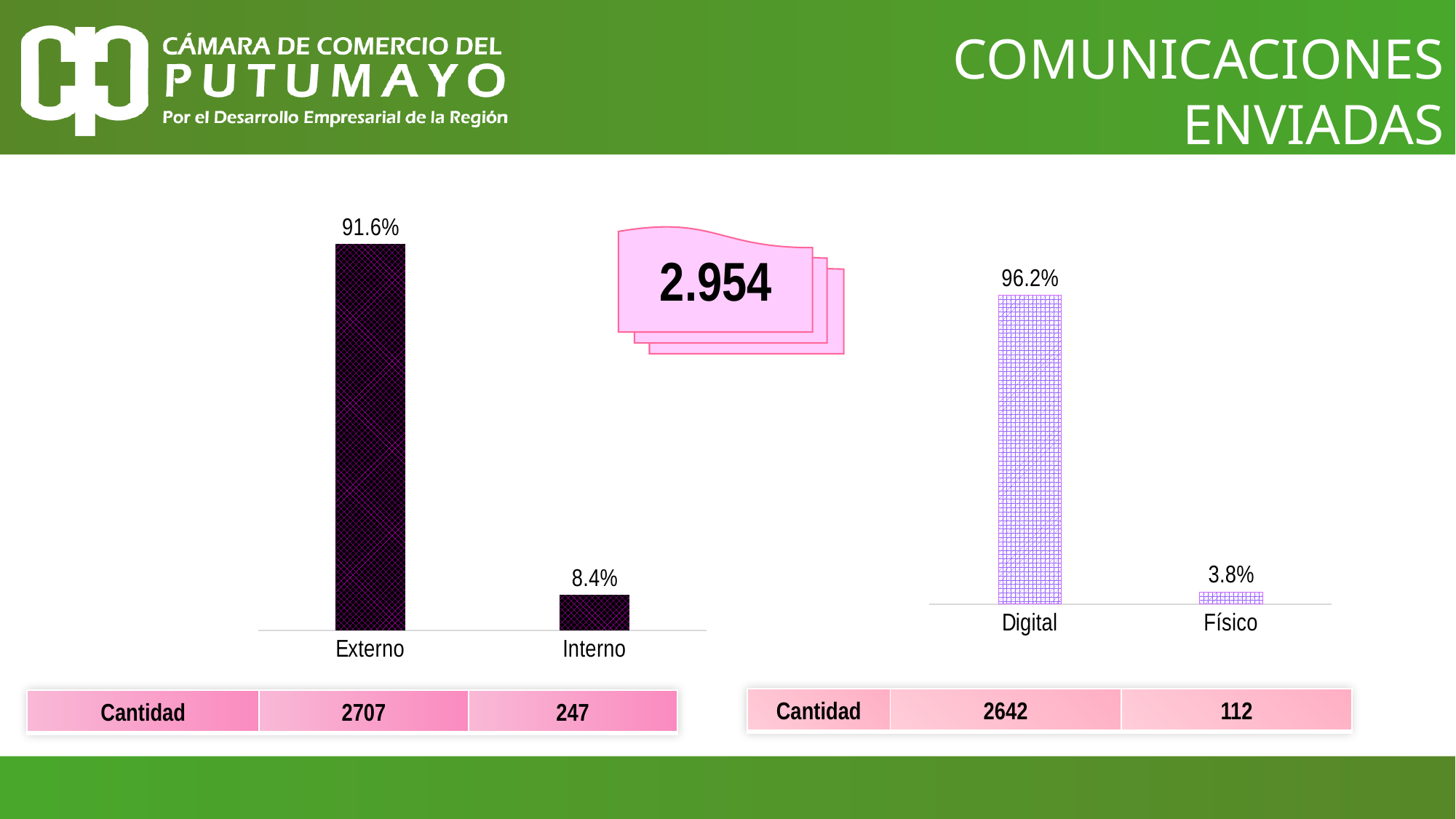
In the left chart, what percentage is shown for Interno? 8.4% In the left chart, which category has the highest value? Externo In the right chart, which category has the lowest value? Físico In the right chart, what is the difference in percentage points between Digital and Físico? 92.4 In the right chart, what percentage is shown for Digital? 96.2% What kind of chart is the right chart? bar chart In the right chart, which is larger, Digital or Físico? Digital In the left chart, what percentage is shown for Externo? 91.6% In the left chart, what is the difference in percentage points between Externo and Interno? 83.2 What total number is shown in the pink box between the two charts? 2.954 How many categories does the left chart show? 2 In the right chart, what percentage is shown for Físico? 3.8%